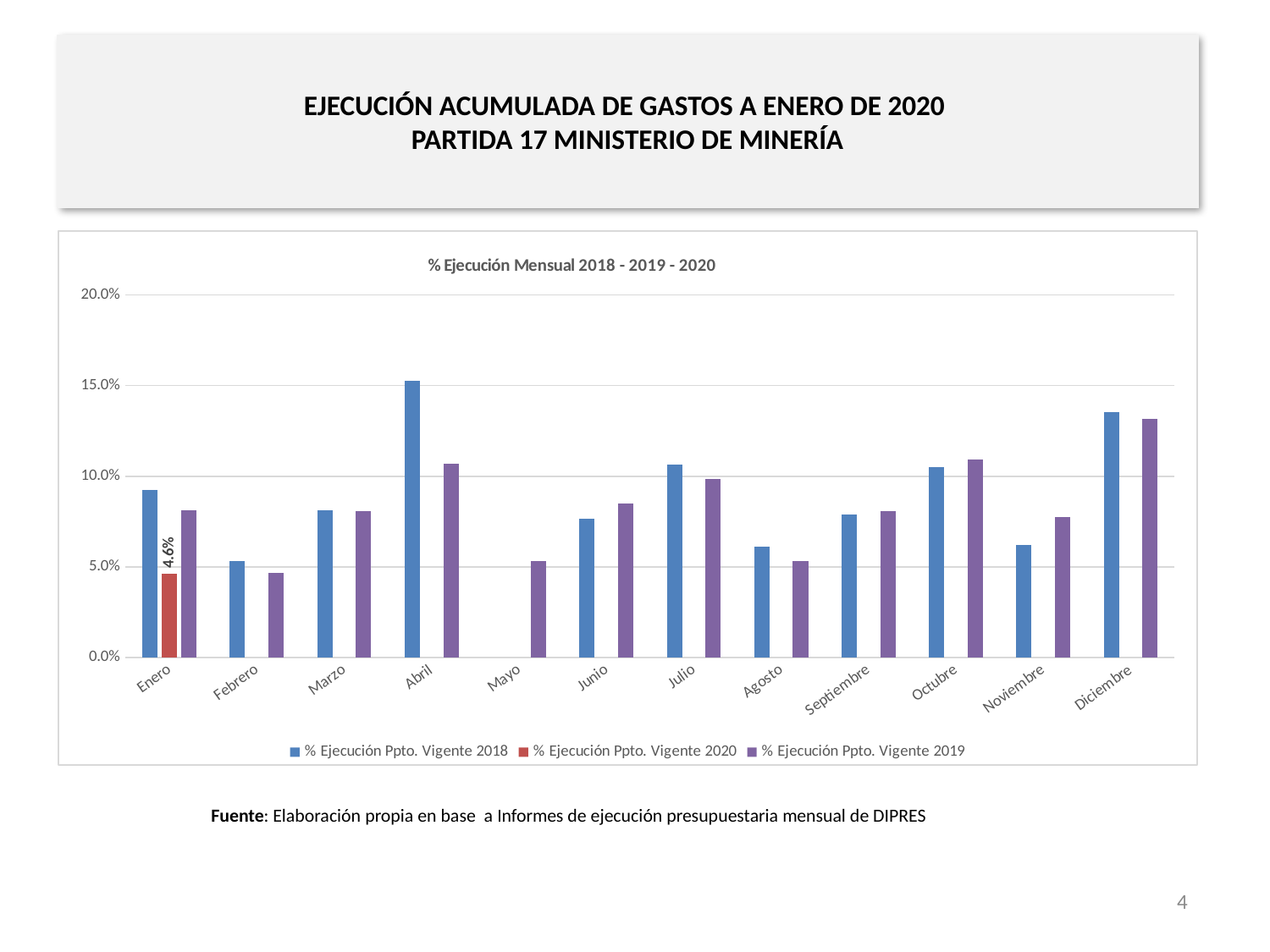
What kind of chart is shown on the slide? bar chart How many months are shown on the x axis? 12 What is the value of the % Ejecución Ppto. Vigente 2020 bar for Enero? 4.6% Which month has the highest % Ejecución Ppto. Vigente 2018 bar? Abril Is the % Ejecución Ppto. Vigente 2019 value for Febrero greater or less than 5.0%? less What is the title of the chart? % Ejecución Mensual 2018 - 2019 - 2020 Which month has the highest % Ejecución Ppto. Vigente 2019 bar? Diciembre For Abril, which is larger: the % Ejecución Ppto. Vigente 2018 bar or the % Ejecución Ppto. Vigente 2019 bar? % Ejecución Ppto. Vigente 2018 How many series does the legend list? 3 Which month has the lowest % Ejecución Ppto. Vigente 2019 bar? Febrero Which month is the only one with a % Ejecución Ppto. Vigente 2020 bar? Enero Is the % Ejecución Ppto. Vigente 2018 value for Abril greater or less than 10.0%? greater